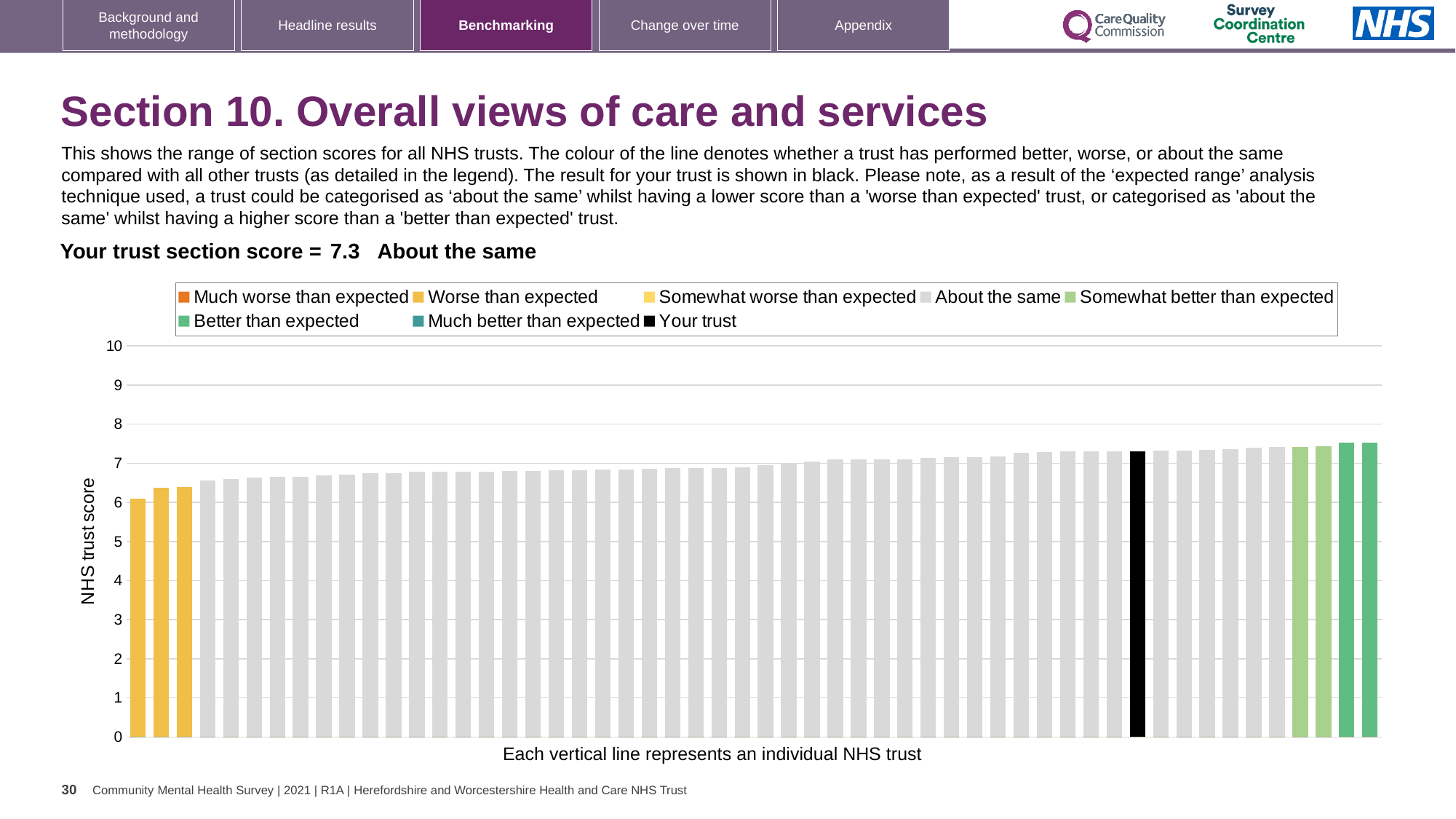
What colour is the bar representing your trust? Black What is the label on the vertical axis of the chart? NHS trust score Do the bar values rise or fall moving from left to right along the x axis? Rise Which performance category is your trust placed in for this section? About the same What kind of chart is shown on the slide? Bar chart Is the value of the lowest bar in the chart greater or less than 7? less Which is larger: the score for your trust (black bar) or the score of the lowest bar in the chart? Your trust How many entries does the chart legend list? 8 What is the section score for your trust shown on the slide? 7.3 Is the value of the highest bar in the chart greater or less than 8? less Is the value of the highest bar in the chart greater or less than 7? greater How many bars are coloured as 'Worse than expected' (yellow) in the chart? 3